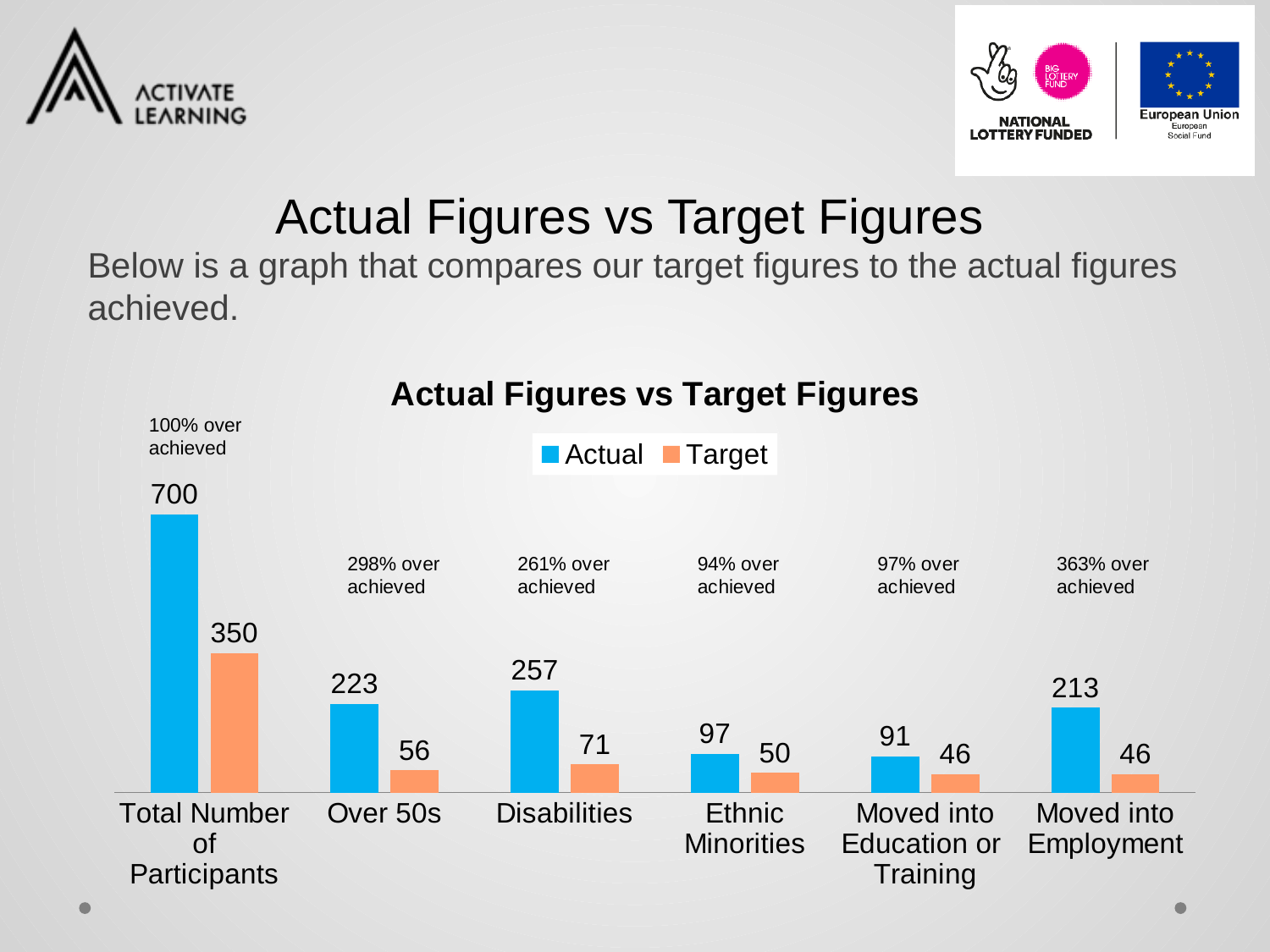
What is the Target value for Disabilities? 71 What is the Target value for Over 50s? 56 How many series does the legend list? 2 Which category has the lowest Actual value? Moved into Education or Training What is the Actual value for Total Number of Participants? 700 How many categories are shown on the x axis? 6 Which is larger, the Actual value for Ethnic Minorities or the Actual value for Moved into Education or Training? Ethnic Minorities What is the difference between the Actual and Target values for Total Number of Participants? 350 Which category has the highest Actual value? Total Number of Participants What kind of chart is shown on the slide? Bar chart What is the difference between the Actual and Target values for Over 50s? 167 What is the Actual value for Moved into Employment? 213